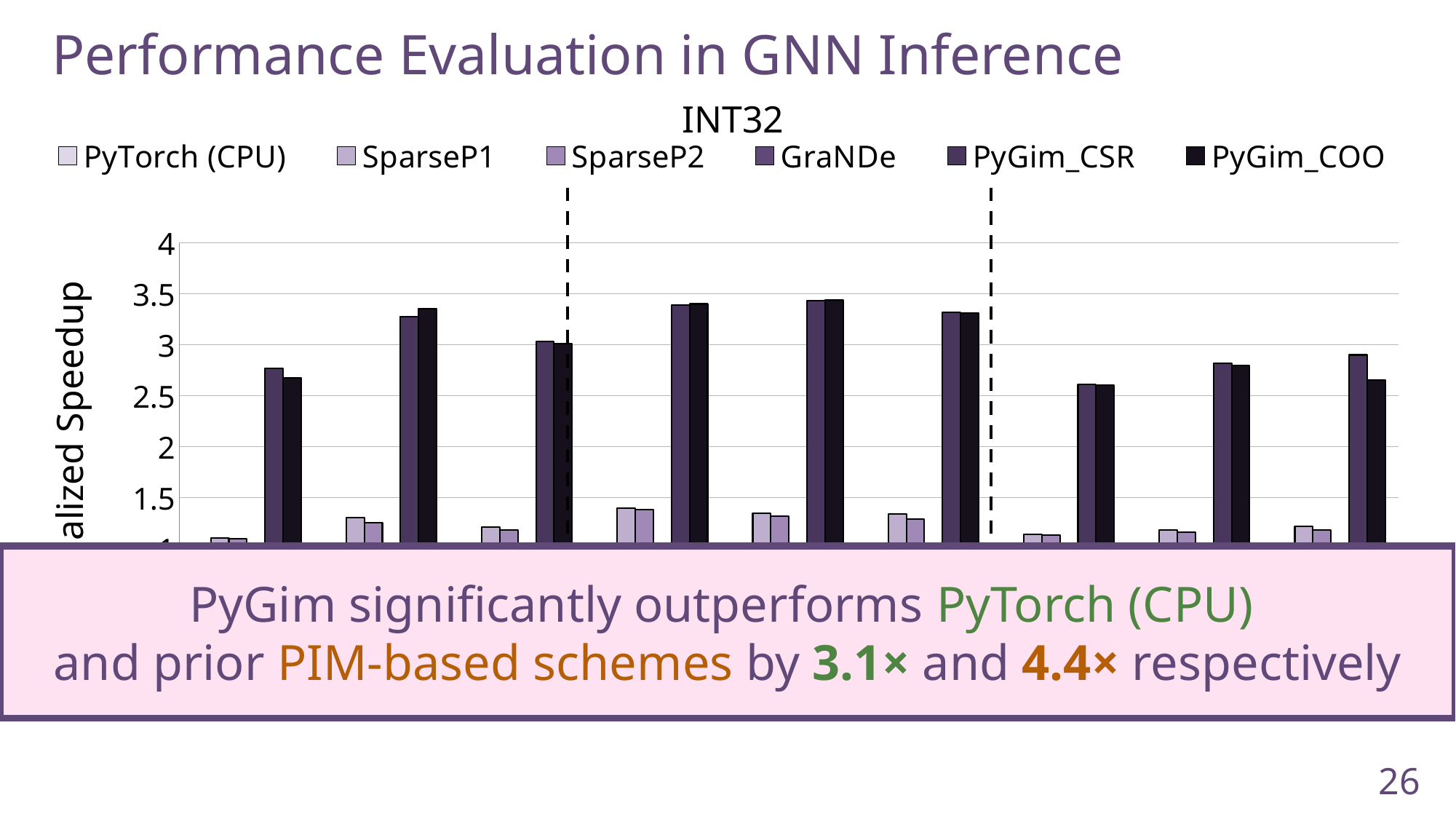
What kind of chart is shown on the slide? bar chart Which series is listed last in the chart's legend? PyGim_COO Is the value of every PyGim_COO bar in the chart greater or less than 3.5? less Is the value of every PyTorch (CPU) bar in the chart greater or less than 1.5? less Is the value of every SparseP1 bar in the chart greater or less than 2? less What is the title shown above the chart's legend? INT32 What is the highest tick value shown on the y axis of the chart? 4 How many series does the legend of the INT32 chart list? 6 How many groups of bars are plotted in the chart? 9